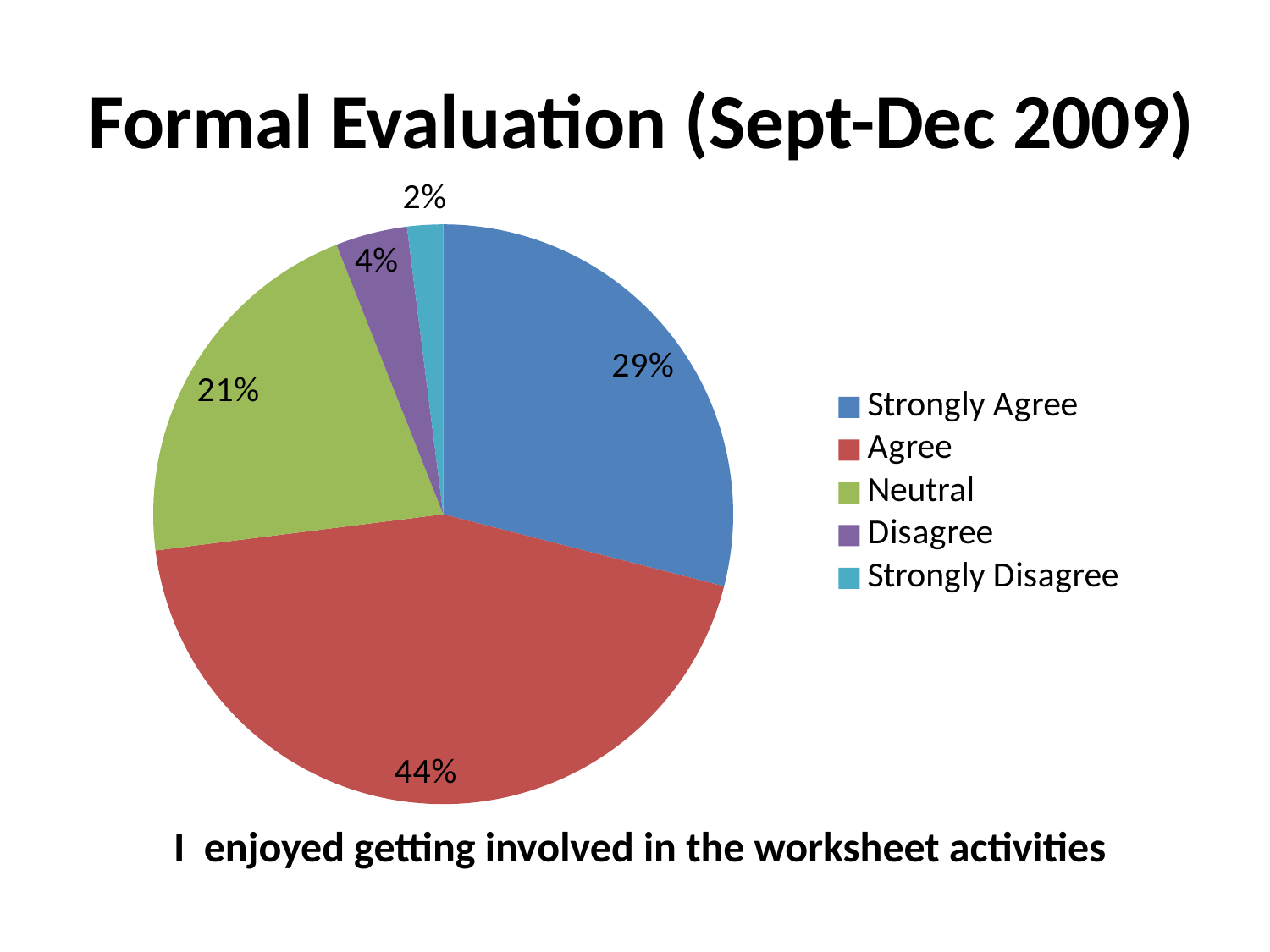
What percentage of respondents answered Strongly Agree? 29% What kind of chart is shown on the slide? Pie chart What percentage of respondents answered Neutral? 21% What is the difference in percentage points between Agree and Strongly Agree? 15 What percentage of respondents answered Strongly Disagree? 2% Which response category has the largest share of the pie? Agree What percentage of respondents answered Agree? 44% What statement were respondents evaluating in this chart? I enjoyed getting involved in the worksheet activities How many response categories does the legend list? 5 Which is larger, the share for Neutral or the share for Disagree? Neutral What percentage of respondents answered Disagree? 4% Which response category has the smallest share of the pie? Strongly Disagree